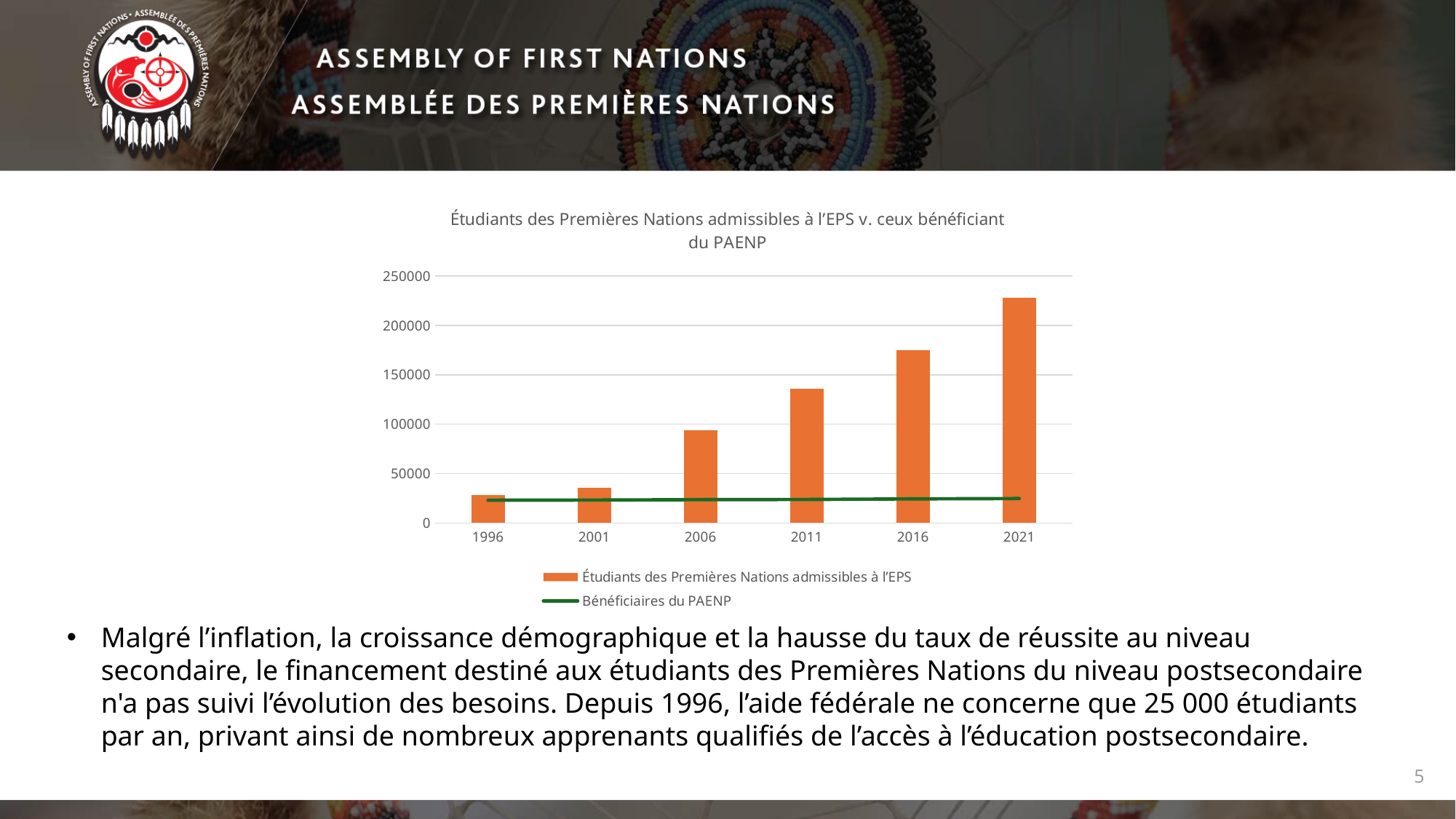
What colour is the line for Bénéficiaires du PAENP? green In which year is the number of Étudiants des Premières Nations admissibles à l'EPS lowest? 1996 How many series does the chart legend list? 2 Is the value for Étudiants des Premières Nations admissibles à l'EPS in 2006 greater or less than 100000? less What kind of chart is used to show the 'Étudiants des Premières Nations admissibles à l'EPS' series? bar chart Which year has the larger value for Étudiants des Premières Nations admissibles à l'EPS, 2006 or 2016? 2016 Is the value for Étudiants des Premières Nations admissibles à l'EPS in 2021 greater or less than 200000? greater Is the value for Bénéficiaires du PAENP in 2021 greater or less than 50000? less Do the values for Étudiants des Premières Nations admissibles à l'EPS rise or fall from 1996 to 2021? rise In which year is the number of Étudiants des Premières Nations admissibles à l'EPS highest? 2021 How many years are shown on the x axis of the chart? 6